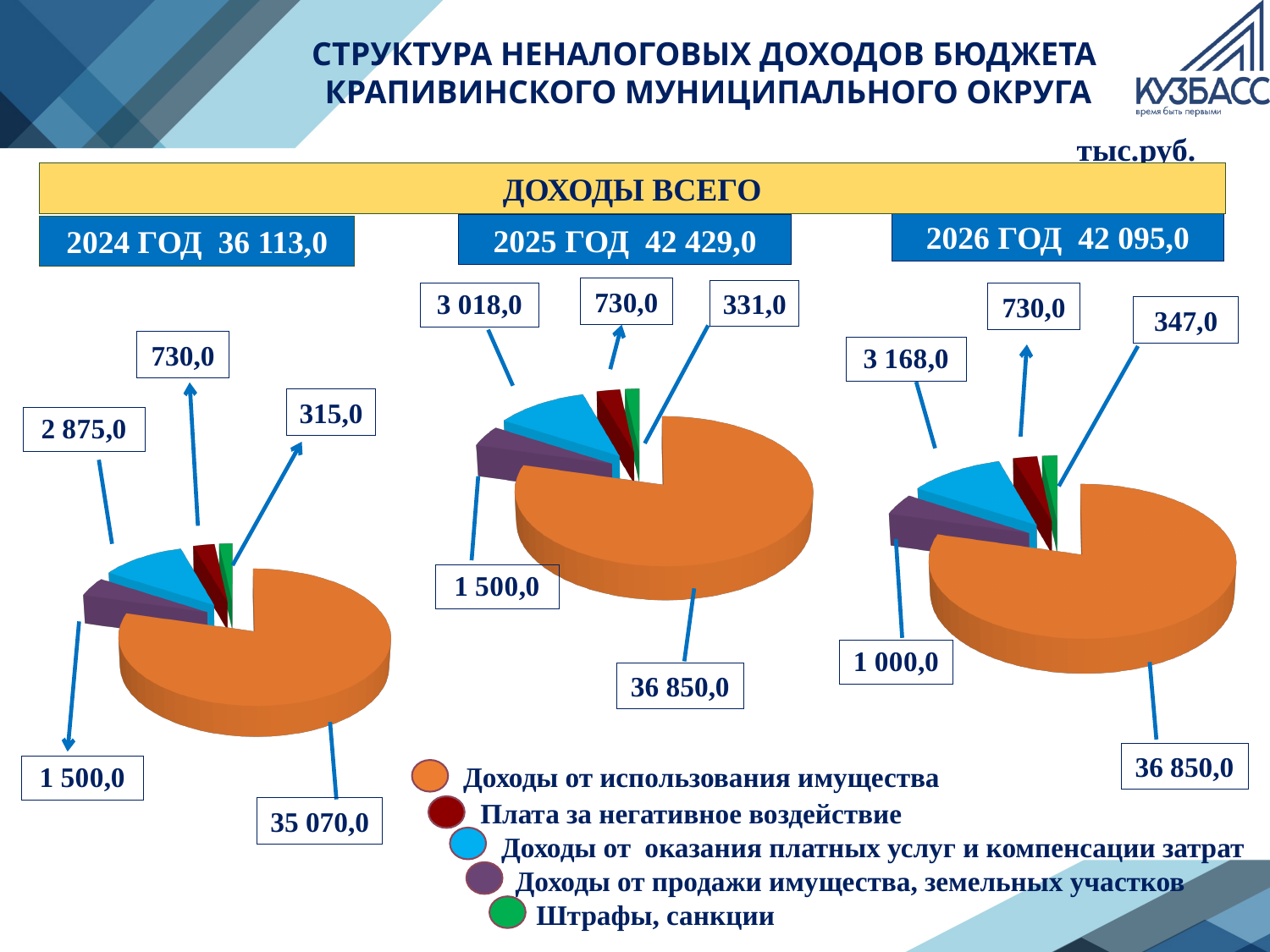
Which is larger on the 2024 pie chart: Плата за негативное воздействие or Штрафы, санкции? Плата за негативное воздействие On the 2024 pie chart, which category has the largest slice? Доходы от использования имущества On the 2024 pie chart, what is the value for Доходы от использования имущества? 35 070,0 On the 2025 pie chart, which category has the smallest slice? Штрафы, санкции What colour represents Плата за негативное воздействие in the legend? Dark red What type of chart is used for each year on the slide? Pie chart On the 2026 pie chart, what is the value for Доходы от продажи имущества, земельных участков? 1 000,0 On the 2026 pie chart, what is the difference between Доходы от оказания платных услуг и компенсации затрат and Доходы от продажи имущества, земельных участков? 2 168,0 How many categories does the legend list? 5 On the 2025 pie chart, what is the value for Доходы от оказания платных услуг и компенсации затрат? 3 018,0 How many slices does the 2025 pie chart have? 5 On the 2026 pie chart, what is the value for Штрафы, санкции? 347,0